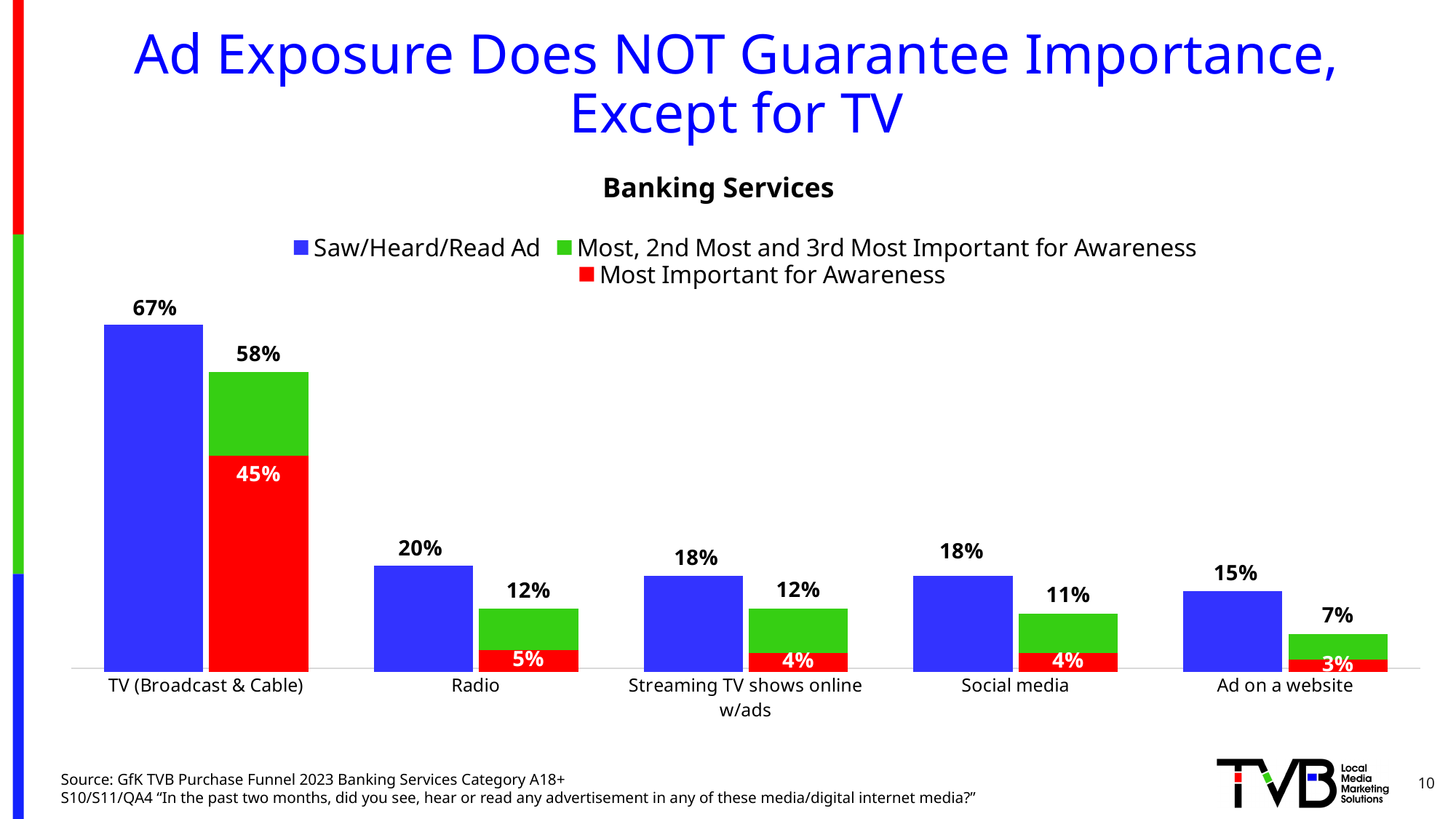
What is the Most Important for Awareness value for Radio? 5% What is the Most, 2nd Most and 3rd Most Important for Awareness value for Social media? 11% What kind of chart is shown on the slide? Bar chart What is the Saw/Heard/Read Ad value for TV (Broadcast & Cable)? 67% What is the difference between the Saw/Heard/Read Ad value and the Most Important for Awareness value for TV (Broadcast & Cable)? 22% Which category has the lowest Most Important for Awareness value? Ad on a website What is the title of the chart? Banking Services What is the Saw/Heard/Read Ad value for Ad on a website? 15% How many series does the legend list? 3 Which is larger: the Saw/Heard/Read Ad value for Radio or for Ad on a website? Radio Which category has the highest Saw/Heard/Read Ad value? TV (Broadcast & Cable) How many media categories are shown on the x axis? 5